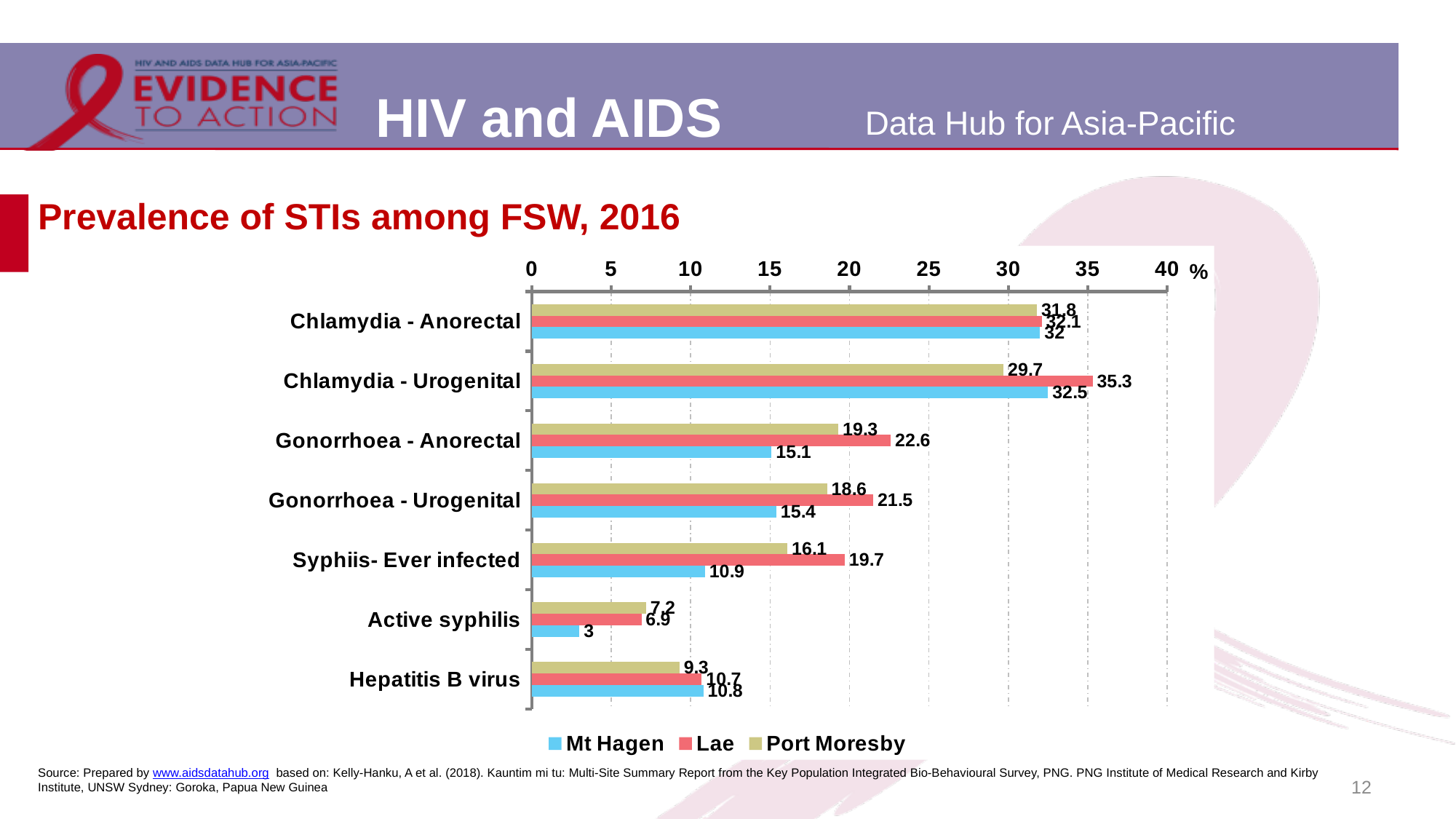
Which site has the lowest prevalence of Syphiis- Ever infected? Mt Hagen Which is larger for Hepatitis B virus: the Lae value or the Port Moresby value? Lae What is the prevalence of Chlamydia - Urogenital for Lae? 35.3 Which site has the highest prevalence of Chlamydia - Urogenital? Lae Which series is shown in red on the chart? Lae What is the prevalence of Syphiis- Ever infected for Port Moresby? 16.1 What is the prevalence of Gonorrhoea - Anorectal for Mt Hagen? 15.1 How many STI categories are shown on the chart? 7 What is the prevalence of Active syphilis for Mt Hagen? 3 What is the difference between the Lae and Mt Hagen values for Gonorrhoea - Urogenital? 6.1 How many series does the legend list? 3 What type of chart is shown on the slide? Bar chart